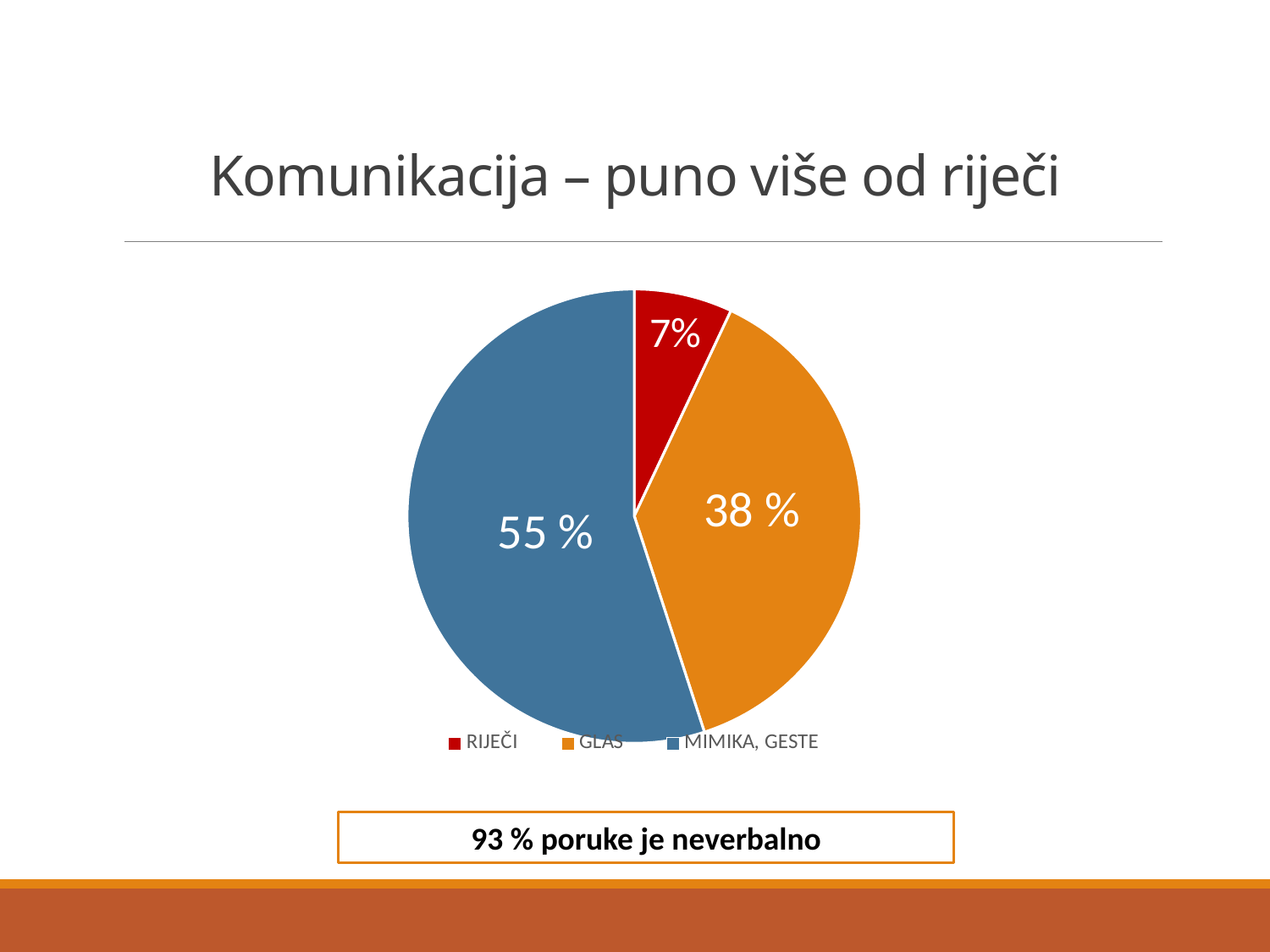
What share of the pie does the MIMIKA, GESTE slice represent? 55 % What kind of chart is shown on the slide? pie chart What share of the pie does the GLAS slice represent? 38 % Which category has the smallest slice of the pie? RIJEČI What is the difference in percentage points between the GLAS slice and the RIJEČI slice? 31 How many slices does the pie chart have? 3 Which slice is larger, GLAS or RIJEČI? GLAS What colour is the RIJEČI slice in the pie chart? red What is the difference in percentage points between the MIMIKA, GESTE slice and the GLAS slice? 17 How many entries does the legend list? 3 What share of the pie does the RIJEČI slice represent? 7% Which category has the largest slice of the pie? MIMIKA, GESTE